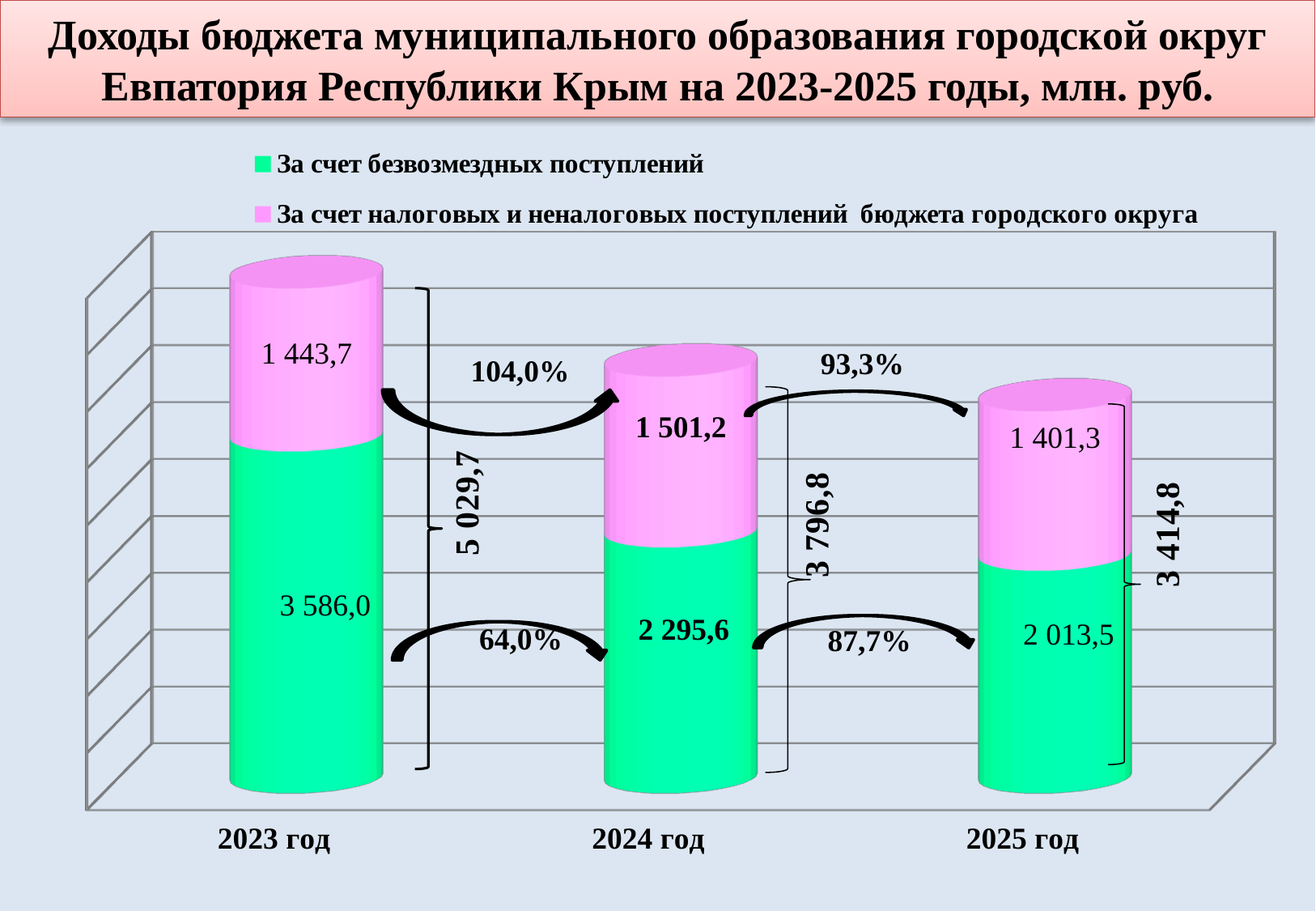
Which is larger: the "За счет налоговых и неналоговых поступлений бюджета городского округа" value in 2024 год or in 2025 год? 2024 год What is the difference between the "За счет безвозмездных поступлений" values for 2023 год and 2024 год? 1 290,4 How many years (categories) are shown on the x axis? 3 What is the value for "За счет налоговых и неналоговых поступлений бюджета городского округа" in 2024 год? 1 501,2 What is the value for "За счет безвозмездных поступлений" in 2025 год? 2 013,5 What is the total of the stacked bar for 2025 год? 3 414,8 What percentage is shown on the arrow between the "За счет безвозмездных поступлений" segments of 2024 год and 2025 год? 87,7% What is the value for "За счет безвозмездных поступлений" in 2023 год? 3 586,0 What is the total of the stacked bar for 2023 год? 5 029,7 Which year has the lowest value for "За счет безвозмездных поступлений"? 2025 год Which year has the highest total budget revenue? 2023 год How many series does the legend list? 2